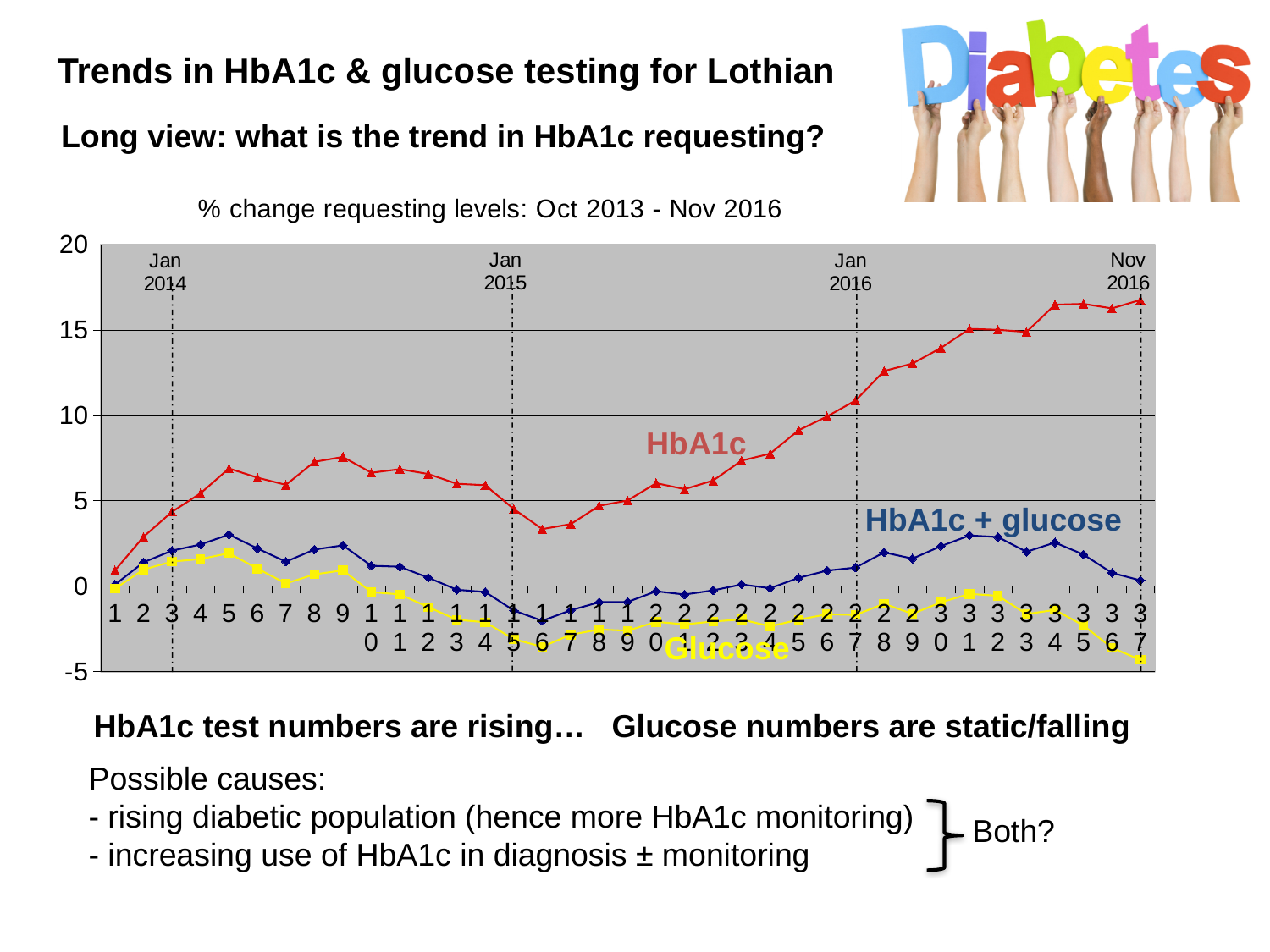
Does the Glucose series rise or fall overall from point 1 to point 37? Fall How many series are plotted on the chart? 3 Is the value of the HbA1c series at point 37 greater or less than 15? greater How many points are numbered along the x axis of the chart? 37 Is the value of the HbA1c series at point 16 greater or less than 5? less Which series reaches the highest value on the chart? HbA1c Which month and year does the last vertical dashed line on the chart mark? Nov 2016 What kind of chart is shown on the slide? Line chart At point 37, which series has the larger value, HbA1c or HbA1c + glucose? HbA1c What is the title of the chart? % change requesting levels: Oct 2013 - Nov 2016 Does the HbA1c series rise or fall overall from point 1 to point 37? Rise Which series has the lowest value at the final point (37) on the chart? Glucose